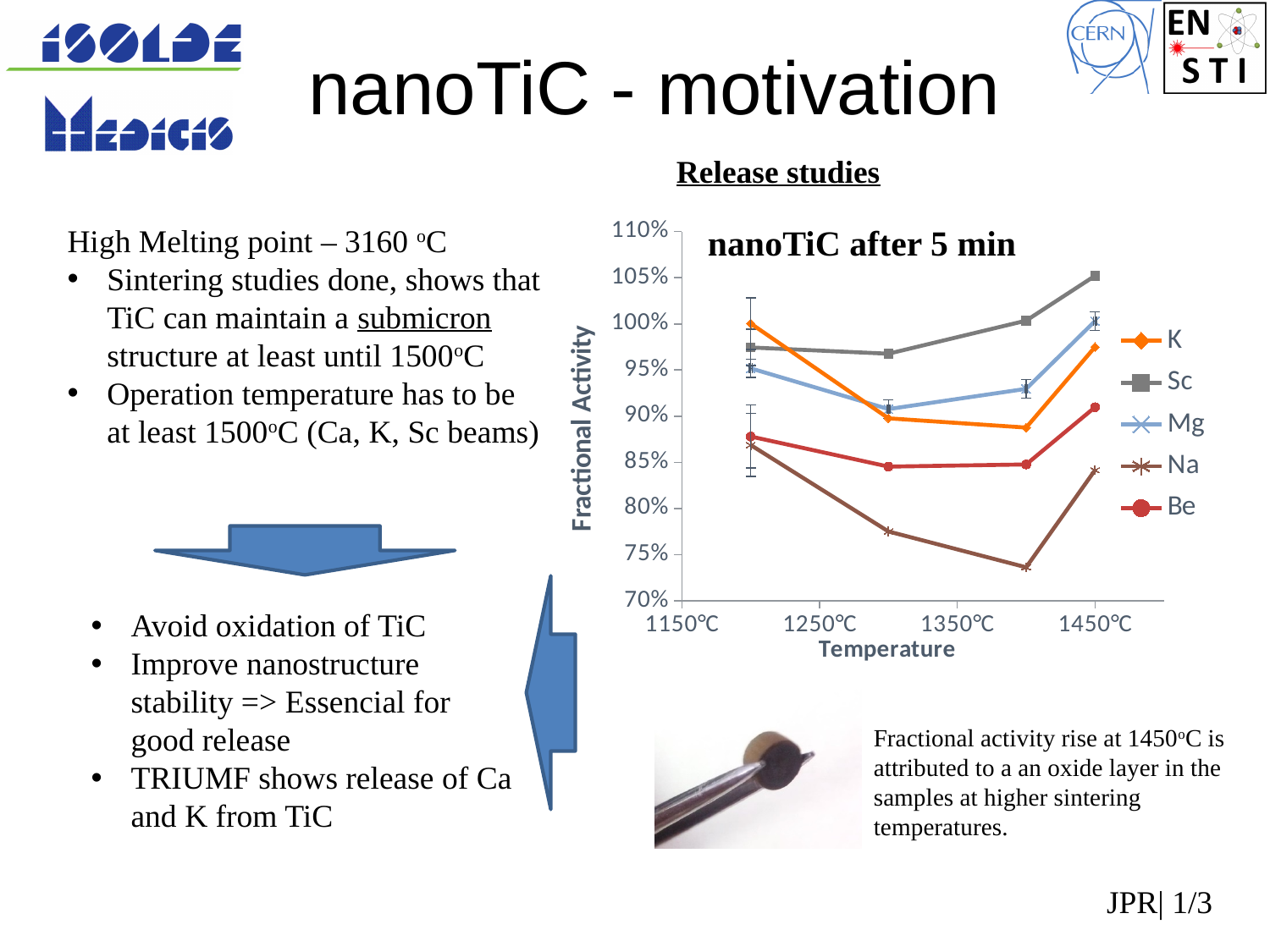
Is the value for Sc at 1450℃ greater or less than 100%? greater What is the title of the chart? nanoTiC after 5 min Which series has the highest fractional activity at 1450℃? Sc Which series has the lowest fractional activity at 1400℃? Na Is the value for Na at 1400℃ greater or less than 75%? less Is the value for Mg at 1400℃ greater or less than 95%? less How many series does the legend of the 'nanoTiC after 5 min' chart list? 5 What kind of chart is shown under 'Release studies'? line chart What is the label of the y axis of the chart? Fractional Activity At 1450℃, which is larger, the value for Mg or the value for Be? Mg Does the Na series rise or fall between 1200℃ and 1400℃? fall